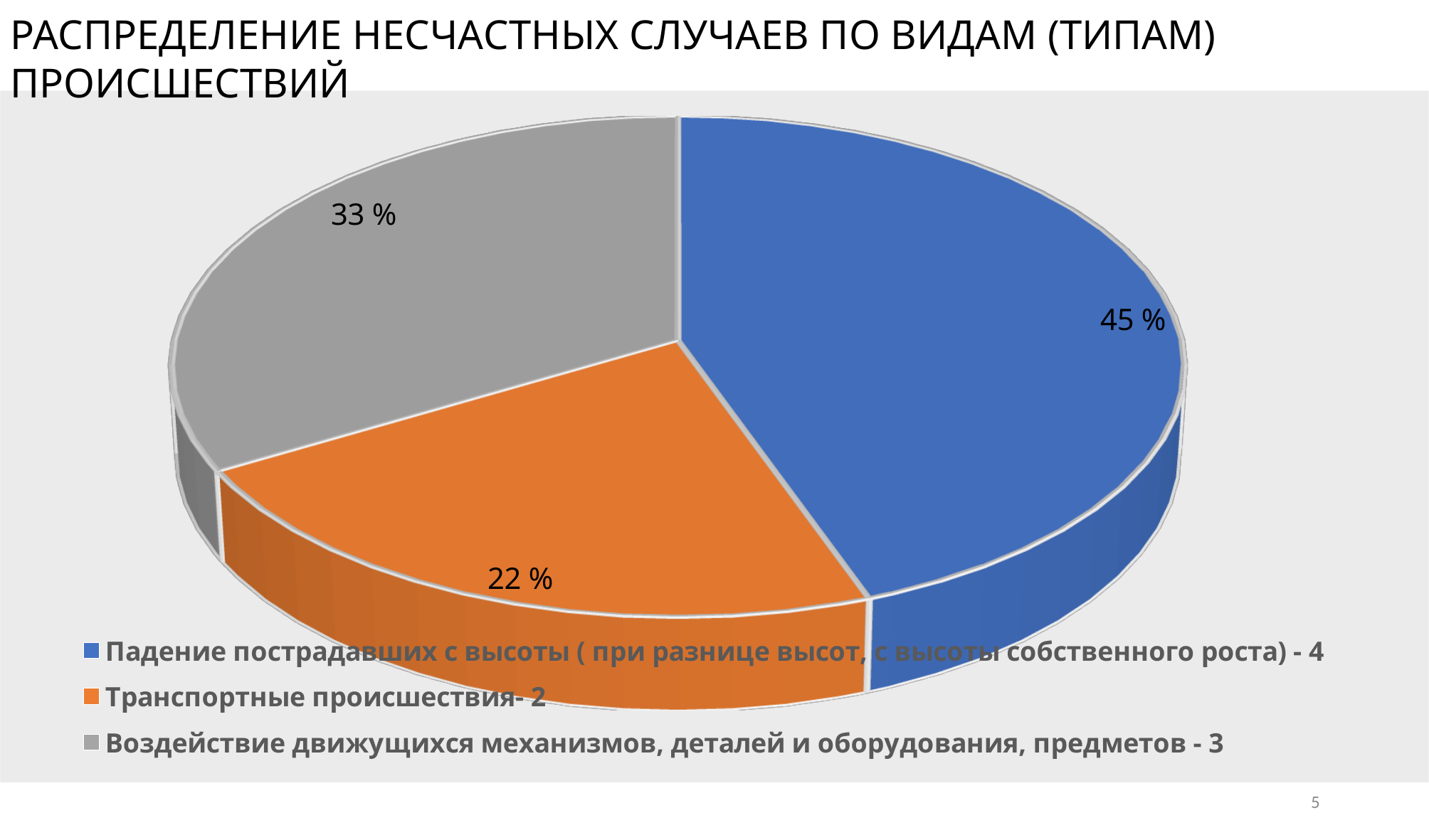
What is the title of the slide? РАСПРЕДЕЛЕНИЕ НЕСЧАСТНЫХ СЛУЧАЕВ ПО ВИДАМ (ТИПАМ) ПРОИСШЕСТВИЙ What type of chart is shown on the slide? Pie chart What percentage share does the slice for "Воздействие движущихся механизмов, деталей и оборудования, предметов" have? 33 % What percentage share does the slice for "Транспортные происшествия" have? 22 % Which category has the smallest slice of the pie? Транспортные происшествия How many categories are shown in the pie chart? 3 What percentage share does the slice for "Падение пострадавших с высоты" have? 45 % Which slice is larger: "Воздействие движущихся механизмов" or "Транспортные происшествия"? Воздействие движущихся механизмов What is the difference in percentage share between "Падение пострадавших с высоты" and "Транспортные происшествия"? 23 % According to the legend, how many cases are attributed to "Транспортные происшествия"? 2 Which category has the largest slice of the pie? Падение пострадавших с высоты What colour is the slice for "Транспортные происшествия"? Orange